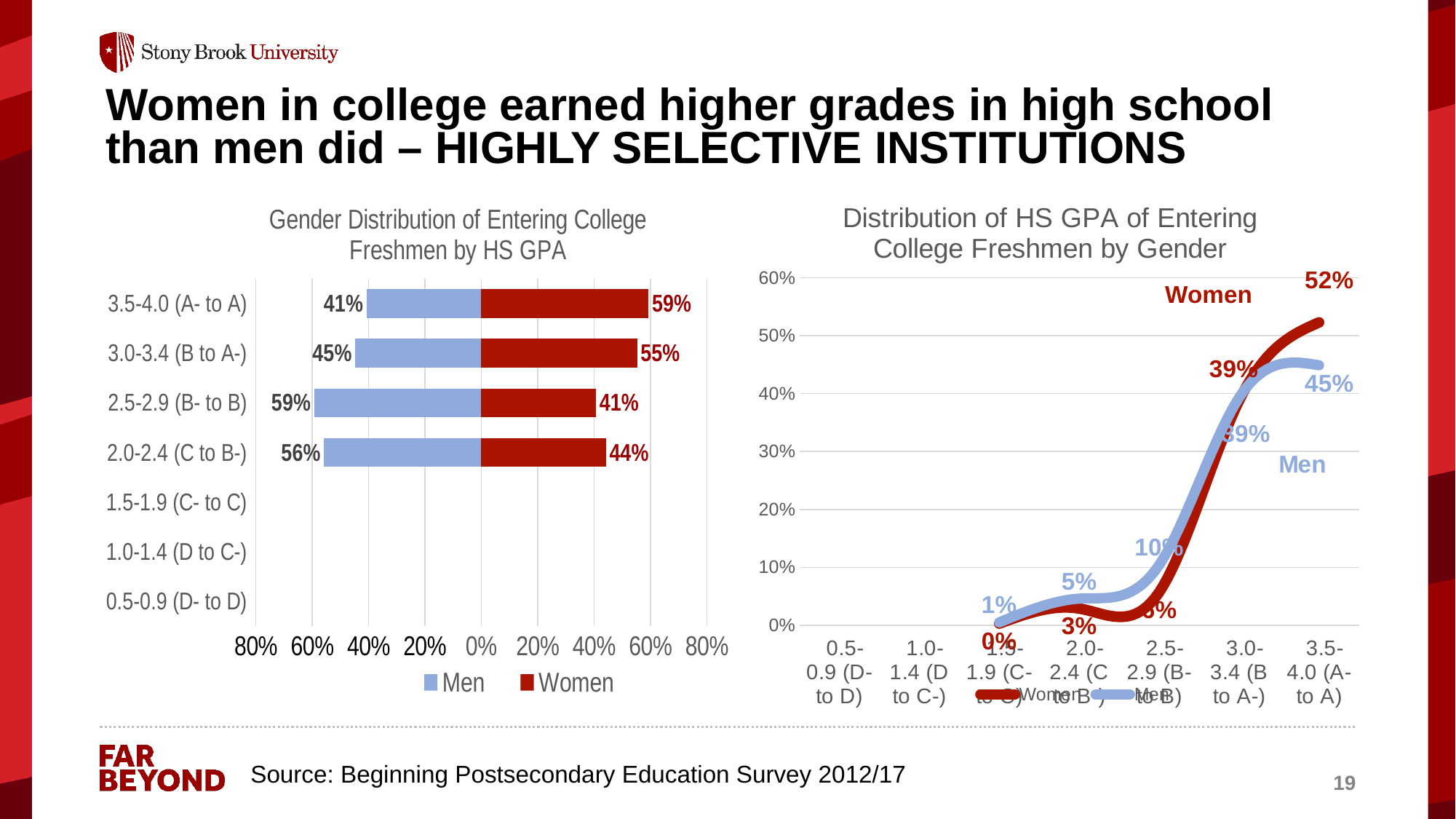
In the left chart, Gender Distribution of Entering College Freshmen by HS GPA, how many series does the legend list? 2 In the left chart, Gender Distribution of Entering College Freshmen by HS GPA, what is the men's share for the 3.0-3.4 (B to A-) GPA band? 45% In the left chart, Gender Distribution of Entering College Freshmen by HS GPA, what percentage of freshmen with a 2.5-2.9 HS GPA are men? 59% What kind of chart is the left chart, Gender Distribution of Entering College Freshmen by HS GPA? Bar chart In the right chart, Distribution of HS GPA of Entering College Freshmen by Gender, what percentage of men had a 3.5-4.0 HS GPA? 45% In the right chart, Distribution of HS GPA of Entering College Freshmen by Gender, what percentage of women had a 3.5-4.0 HS GPA? 52% In the right chart, Distribution of HS GPA of Entering College Freshmen by Gender, which is larger at the 2.0-2.4 GPA band, the men's value or the women's value? Men In the left chart, Gender Distribution of Entering College Freshmen by HS GPA, which GPA band has the highest women's share? 3.5-4.0 (A- to A) In the left chart, Gender Distribution of Entering College Freshmen by HS GPA, what percentage of freshmen with a 3.5-4.0 HS GPA are women? 59% What kind of chart is the right chart, Distribution of HS GPA of Entering College Freshmen by Gender? Line chart In the left chart, Gender Distribution of Entering College Freshmen by HS GPA, what is the difference between the women's and men's shares in the 2.0-2.4 (C to B-) band? 12% In the right chart, Distribution of HS GPA of Entering College Freshmen by Gender, what is the women's value for the 3.0-3.4 GPA band? 39%